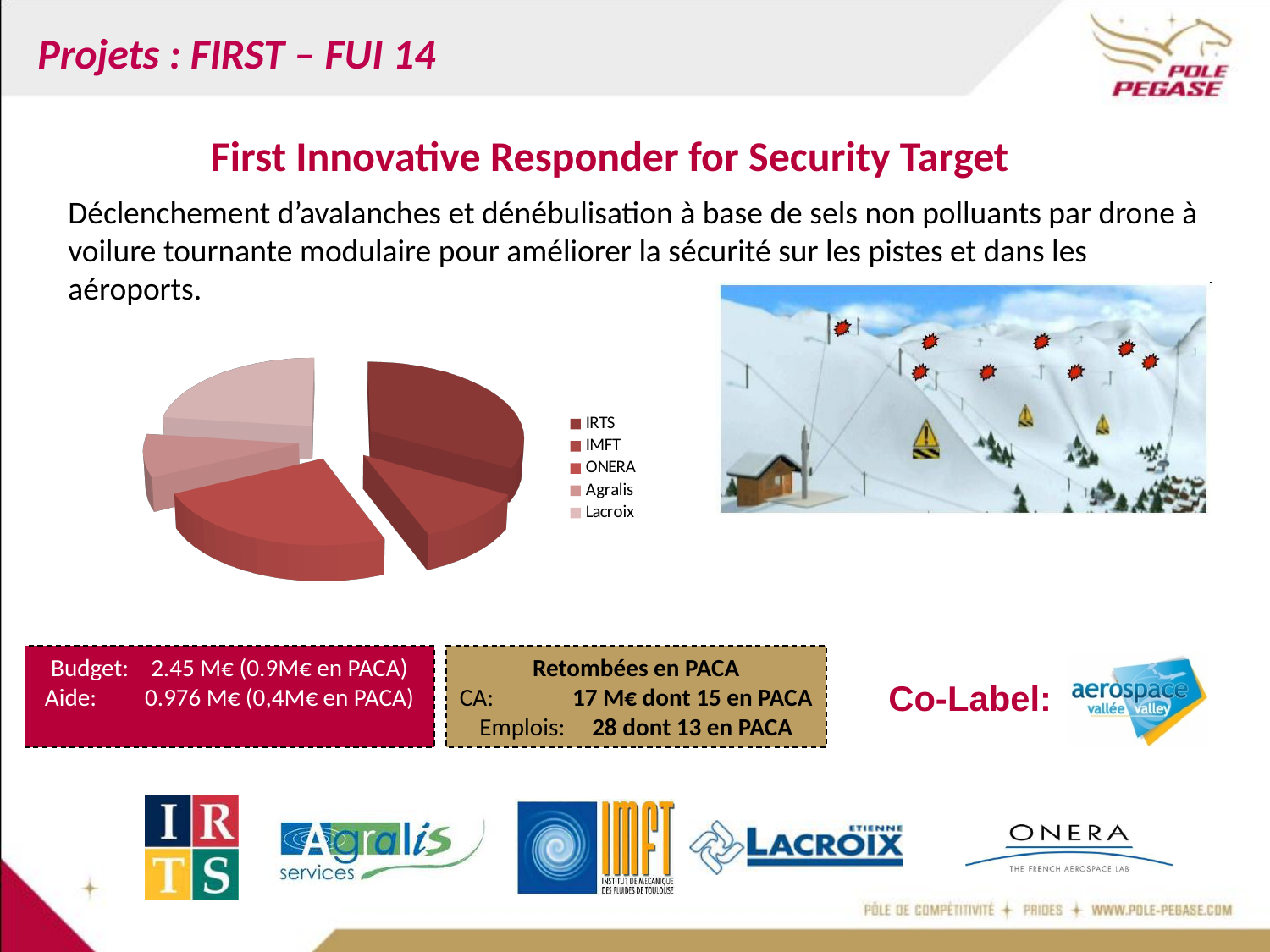
What kind of chart is shown on the slide? pie chart In the pie chart, which slice is larger, IRTS or ONERA? IRTS How many slices does the pie chart have? 5 Which is the first entry in the pie chart's legend? IRTS How many entries does the pie chart's legend list? 5 Which entries are listed in the pie chart's legend? IRTS, IMFT, ONERA, Agralis, Lacroix In the pie chart, which slice is larger, IRTS or Agralis? IRTS